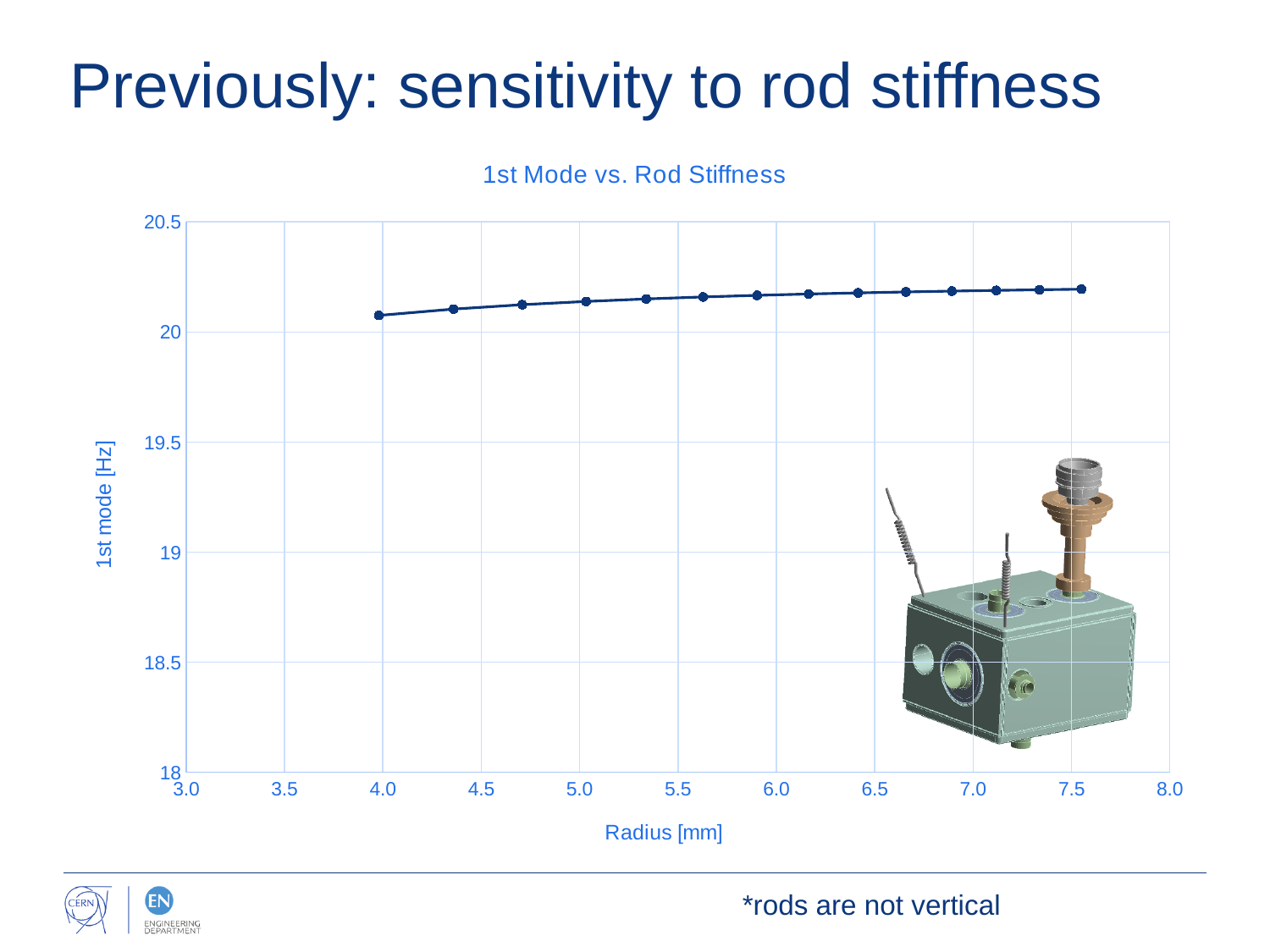
Are all plotted 1st mode values greater or less than 20 Hz? greater Is the 1st mode value at a radius of 7.5 mm greater or less than 20.5 Hz? less How many data points are plotted on the chart? 14 Which has the larger 1st mode value: the point at a radius of about 4.0 mm or the point at about 7.5 mm? the point at about 7.5 mm What is the label of the x axis of the chart? Radius [mm] What is the title of the chart? 1st Mode vs. Rod Stiffness Does the 1st mode rise or fall as the radius increases along the x axis? rise Is the 1st mode value at a radius of 4.0 mm greater or less than 20 Hz? greater What kind of chart is shown on the slide? line chart At which end of the radius range is the 1st mode lowest: the smallest radius (about 4.0 mm) or the largest radius (about 7.5 mm)? the smallest radius (about 4.0 mm) At which end of the radius range is the 1st mode highest: the smallest radius (about 4.0 mm) or the largest radius (about 7.5 mm)? the largest radius (about 7.5 mm)